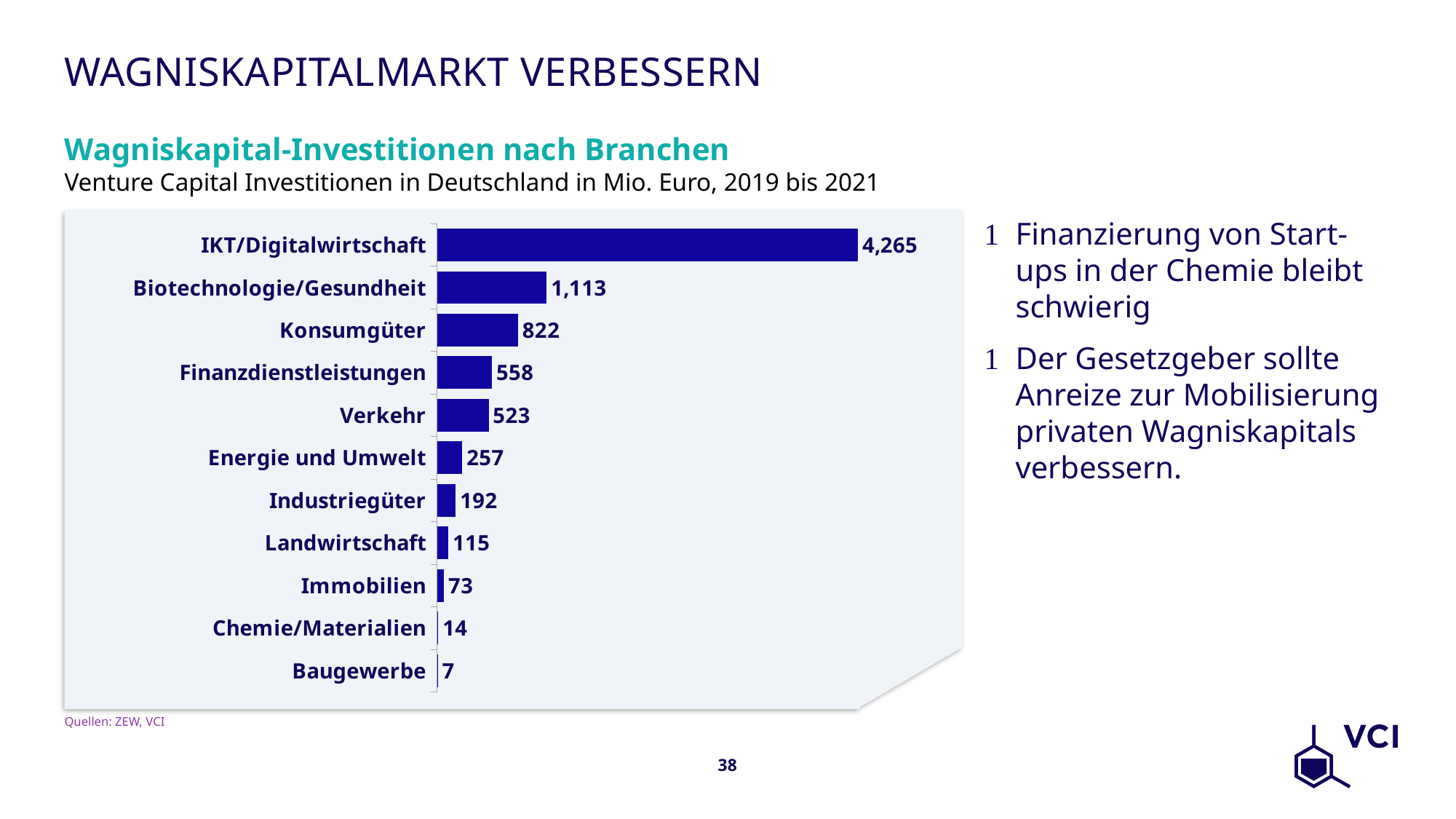
What kind of chart is shown on the slide? Bar chart Which is larger, the value for Energie und Umwelt or the value for Industriegüter? Energie und Umwelt What is the difference between the values for Biotechnologie/Gesundheit and Konsumgüter? 291 What sources are cited for the chart? ZEW, VCI What is the difference between the values for Finanzdienstleistungen and Verkehr? 35 What is the value for IKT/Digitalwirtschaft? 4,265 What is the value for Chemie/Materialien? 14 How many categories are shown in the chart? 11 Which category has the highest value? IKT/Digitalwirtschaft What is the value for Verkehr? 523 What is the title of the chart? Wagniskapital-Investitionen nach Branchen Which category has the lowest value? Baugewerbe